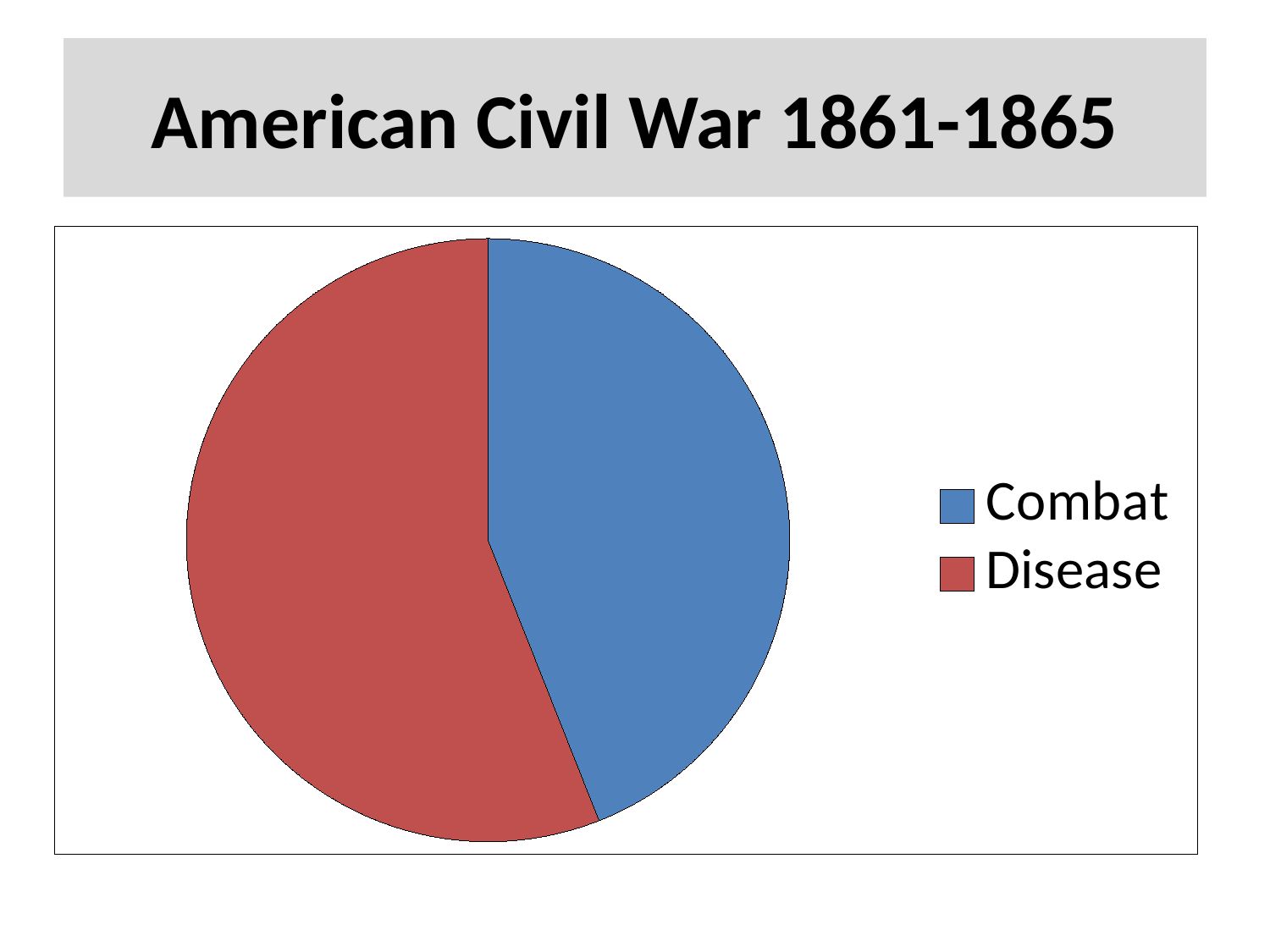
What colour is the Combat slice? blue Which category has the smallest slice of the pie chart? Combat How many slices does the pie chart have? 2 What kind of chart is shown on the slide? pie chart What is the title of the slide containing the pie chart? American Civil War 1861-1865 Which category has the largest slice of the pie chart? Disease Which slice is larger, Combat or Disease? Disease Does the Combat slice take up more or less than half of the pie? less Does the Disease slice take up more or less than half of the pie? more